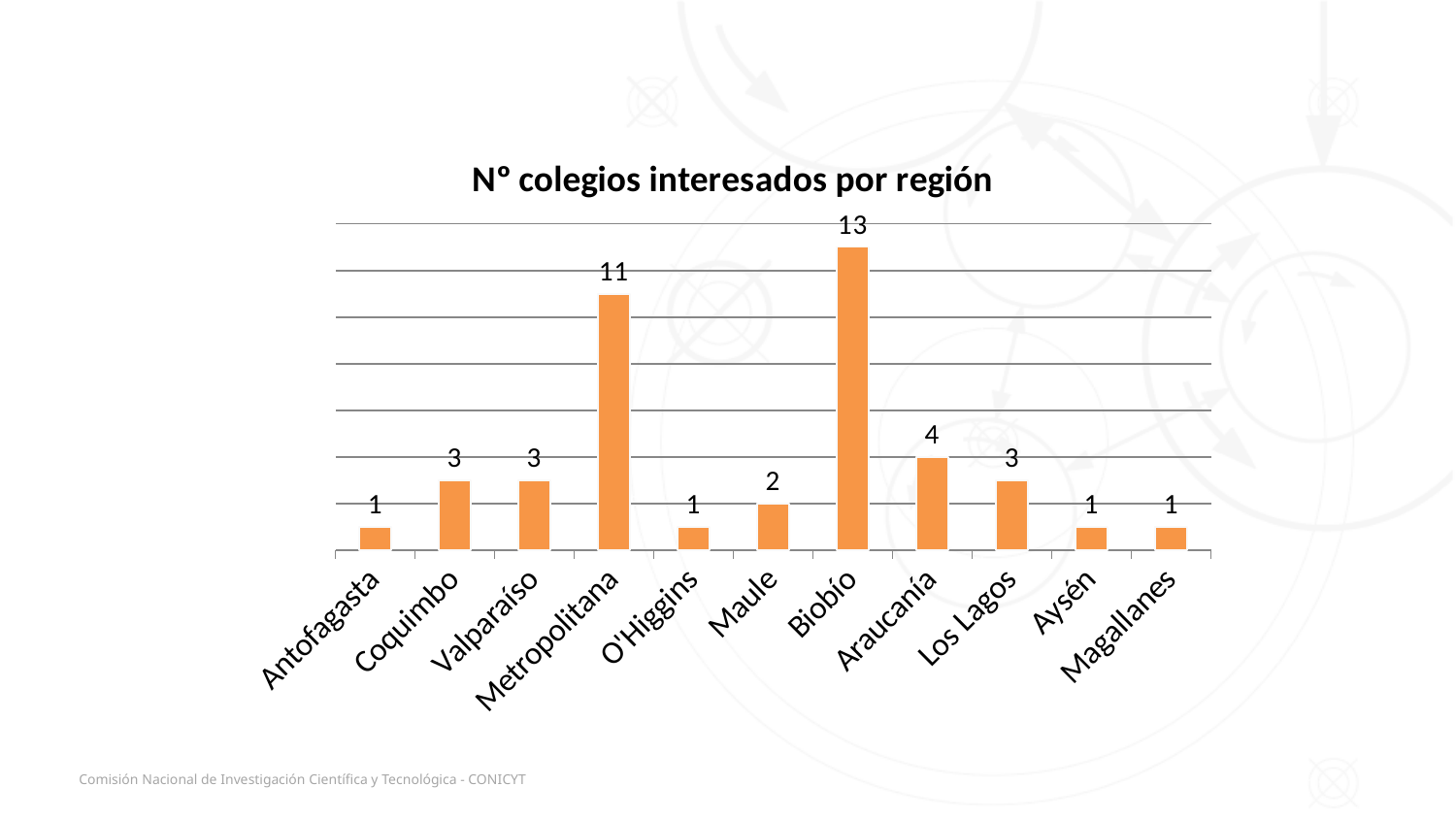
What is the value for Metropolitana? 11 What is the value for Biobío? 13 How many regions are shown on the x axis? 11 Which region has the highest value? Biobío What is the value for Araucanía? 4 What kind of chart is this? Bar chart What is the value for Maule? 2 What is the difference between the values for Biobío and Metropolitana? 2 Which is larger, the value for Araucanía or the value for Los Lagos? Araucanía What is the title of the chart? N° colegios interesados por región How many regions have a value of 1? 4 What is the difference between the values for Coquimbo and Antofagasta? 2